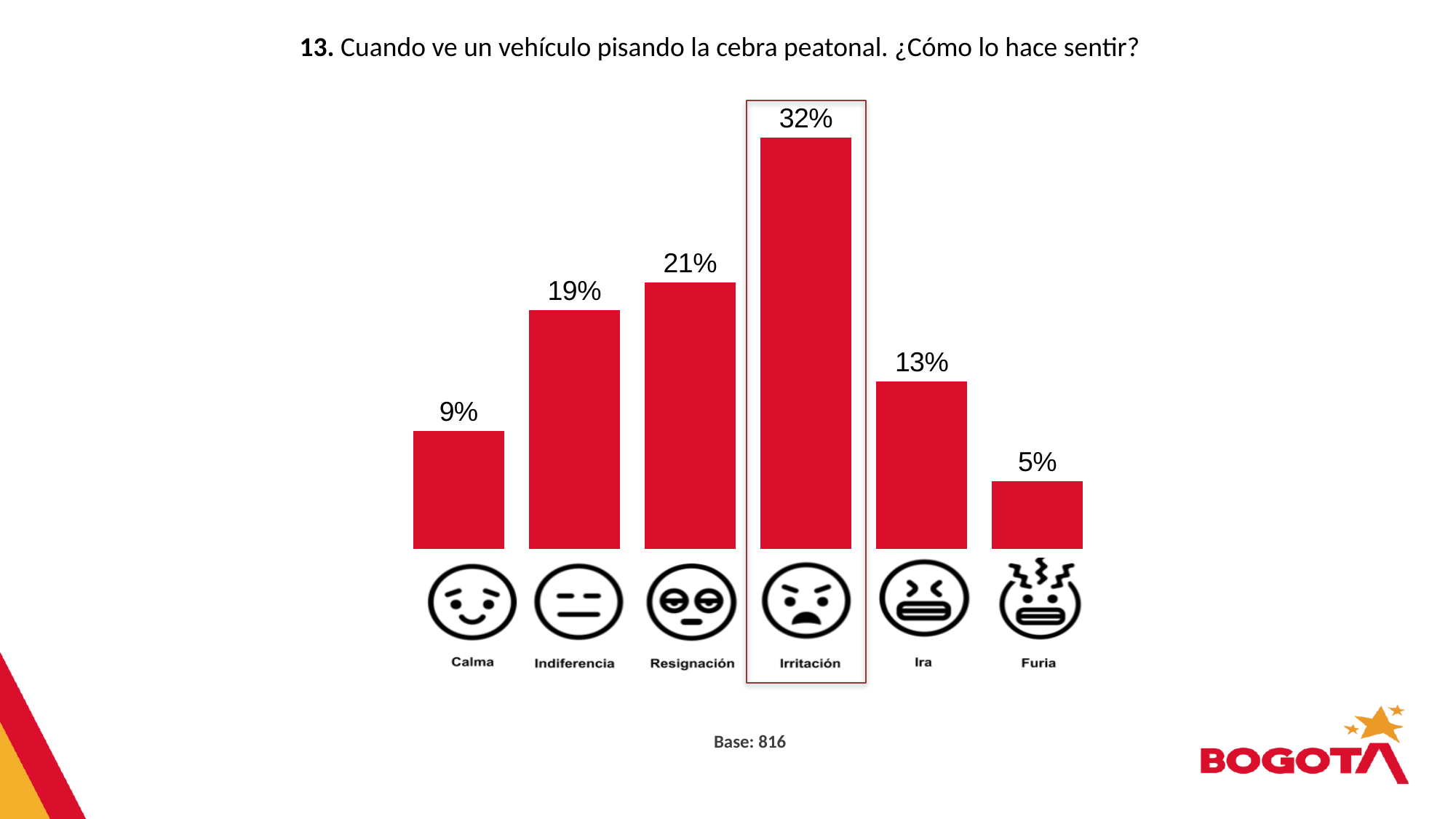
What percentage of respondents answered Irritación? 32% What kind of chart is shown on the slide? Bar chart What is the value shown for Calma? 9% What is the base (number of respondents) stated below the chart? 816 How many categories are shown in the chart? 6 What is the value for Ira? 13% What is the difference between the values for Indiferencia and Calma? 10% What is the difference between the values for Irritación and Resignación? 11% What percentage is shown for Resignación? 21% Which category has the lowest value? Furia Which category has the highest value? Irritación Which is larger, the value for Ira or the value for Indiferencia? Indiferencia